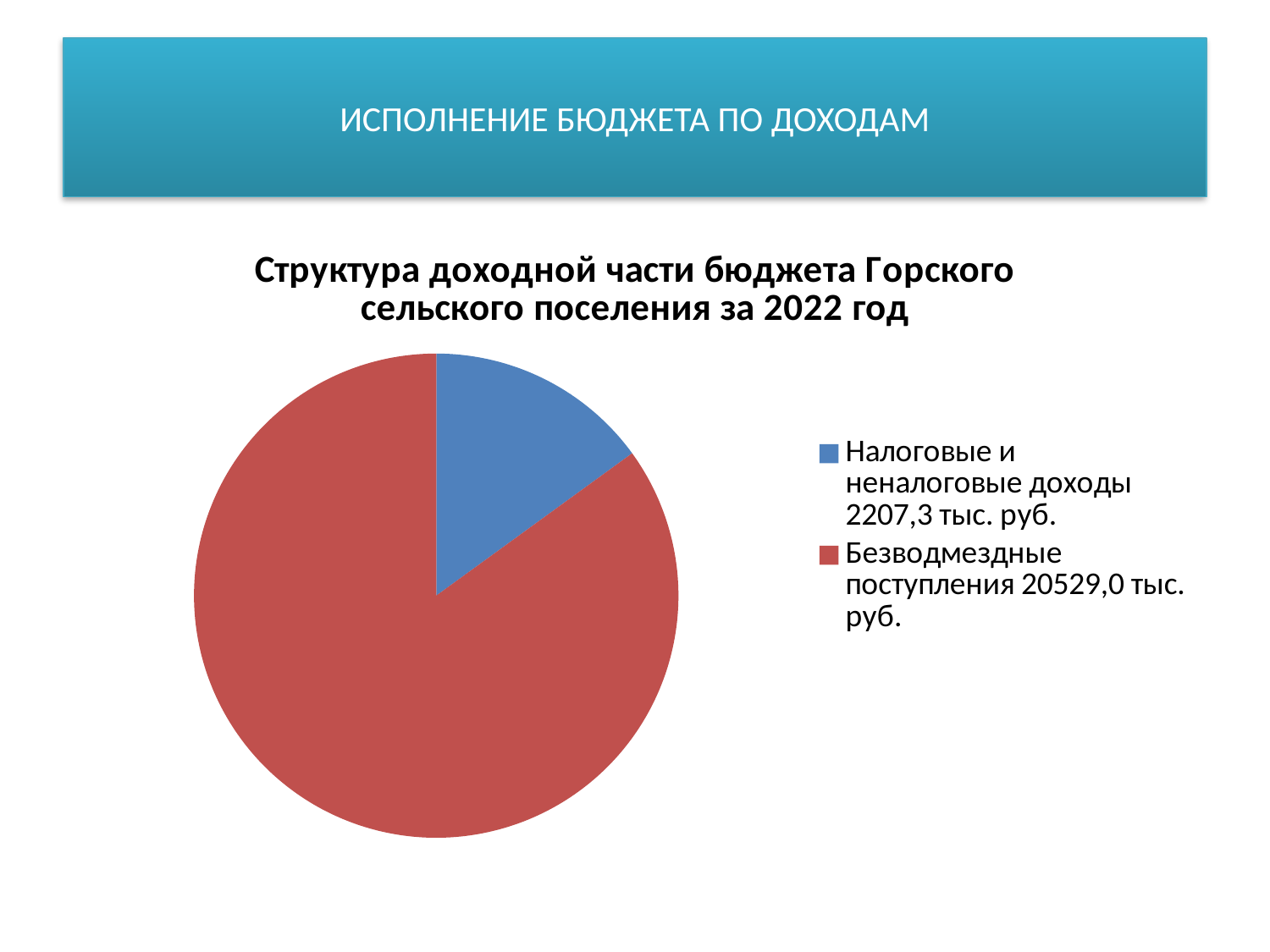
What kind of chart is shown on the slide? Pie chart Which category has the smallest slice of the pie? Налоговые и неналоговые доходы What is the difference between Безводмездные поступления and Налоговые и неналоговые доходы? 18321,7 тыс. руб. What colour is the slice for Безводмездные поступления? Red How many slices does the pie chart have? 2 Which is larger: Налоговые и неналоговые доходы or Безводмездные поступления? Безводмездные поступления What is the value for Безводмездные поступления? 20529,0 тыс. руб. What is the value for Налоговые и неналоговые доходы? 2207,3 тыс. руб. What is the total of the two categories shown in the pie chart? 22736,3 тыс. руб. How many entries does the legend list? 2 What is the title of the chart? Структура доходной части бюджета Горского сельского поселения за 2022 год Which category has the largest slice of the pie? Безводмездные поступления